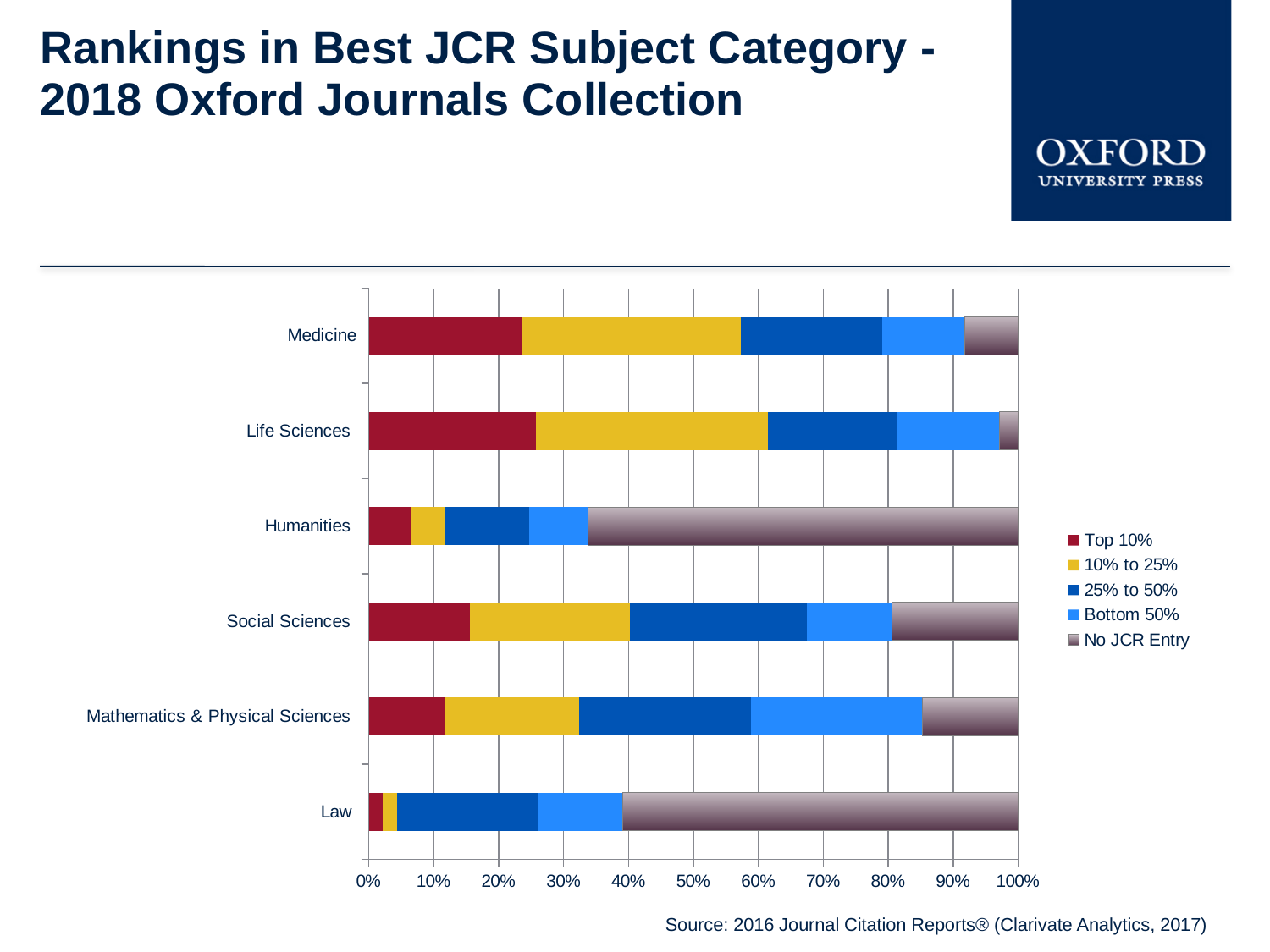
Which subject category has the smallest No JCR Entry segment? Life Sciences What does each stacked bar total on the x axis? 100% Is the Top 10% share for Medicine greater or less than 20%? greater How many series does the legend list? 5 Which series is shown in red in the legend? Top 10% Is the No JCR Entry share for Humanities greater or less than 60%? greater Which subject category has the largest No JCR Entry segment? Humanities Is the Top 10% share for Social Sciences greater or less than 20%? less Which subject category has the smallest Top 10% segment? Law What kind of chart is shown on the slide? Stacked bar chart How many subject categories are plotted on the chart? 6 Which has a larger Top 10% segment, Medicine or Humanities? Medicine